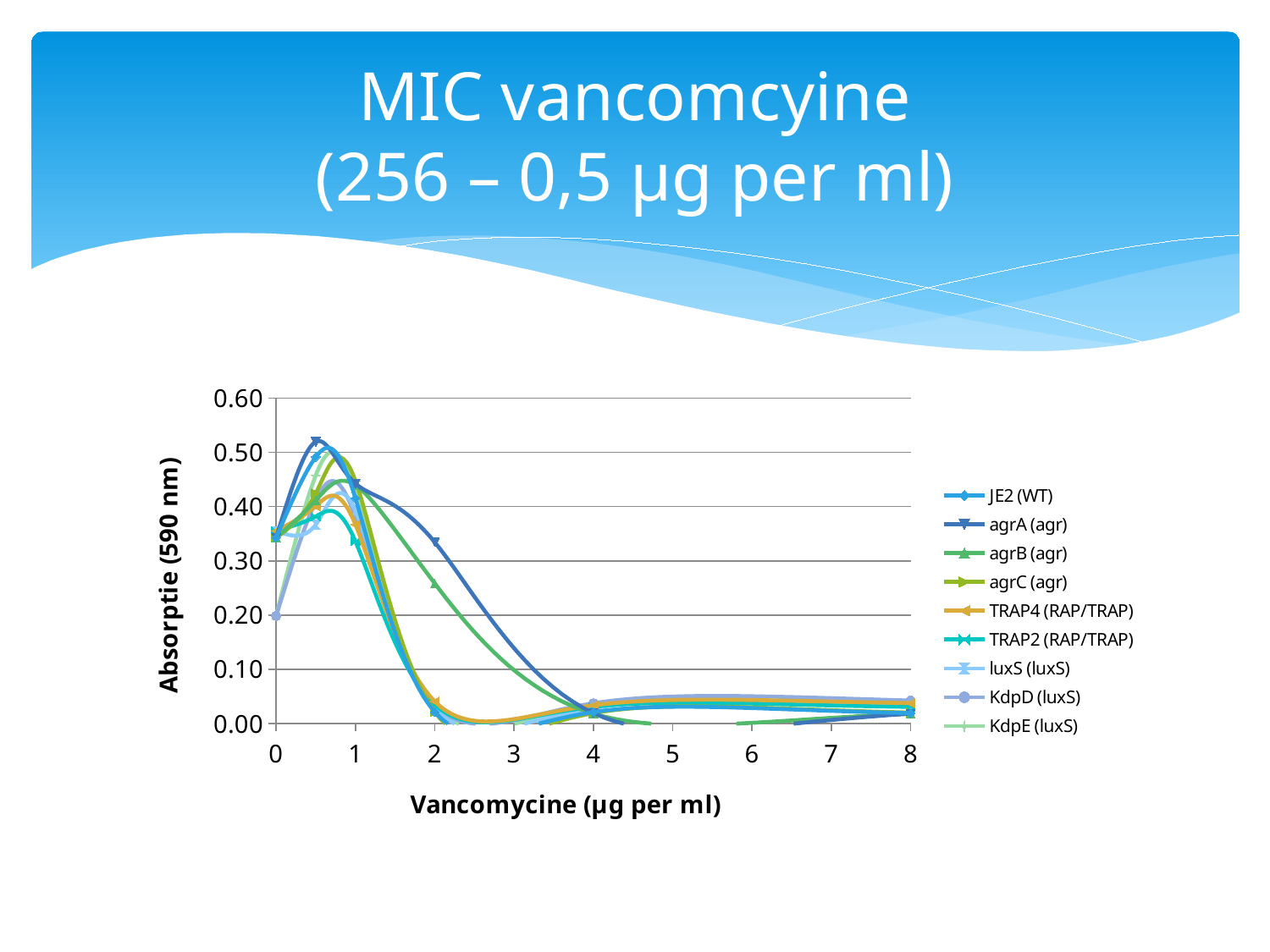
What is the title of the x axis? Vancomycine (µg per ml) How many series does the legend list? 9 Is the value for agrB (agr) at a vancomycine concentration of 2 greater or less than 0.20? greater Is the value for TRAP2 (RAP/TRAP) at a vancomycine concentration of 8 greater or less than 0.10? less What is the title of the y axis? Absorptie (590 nm) What kind of chart is shown on the slide? Line chart Is the value for agrA (agr) at a vancomycine concentration of 2 greater or less than 0.20? greater Do the values for agrB (agr) rise or fall between vancomycine concentrations of 2 and 4? fall At a vancomycine concentration of 2, which series has the larger value, agrA (agr) or JE2 (WT)? agrA (agr) Do the values for JE2 (WT) rise or fall between vancomycine concentrations of 1 and 2? fall Which series reaches the highest absorption value on the chart? agrA (agr)